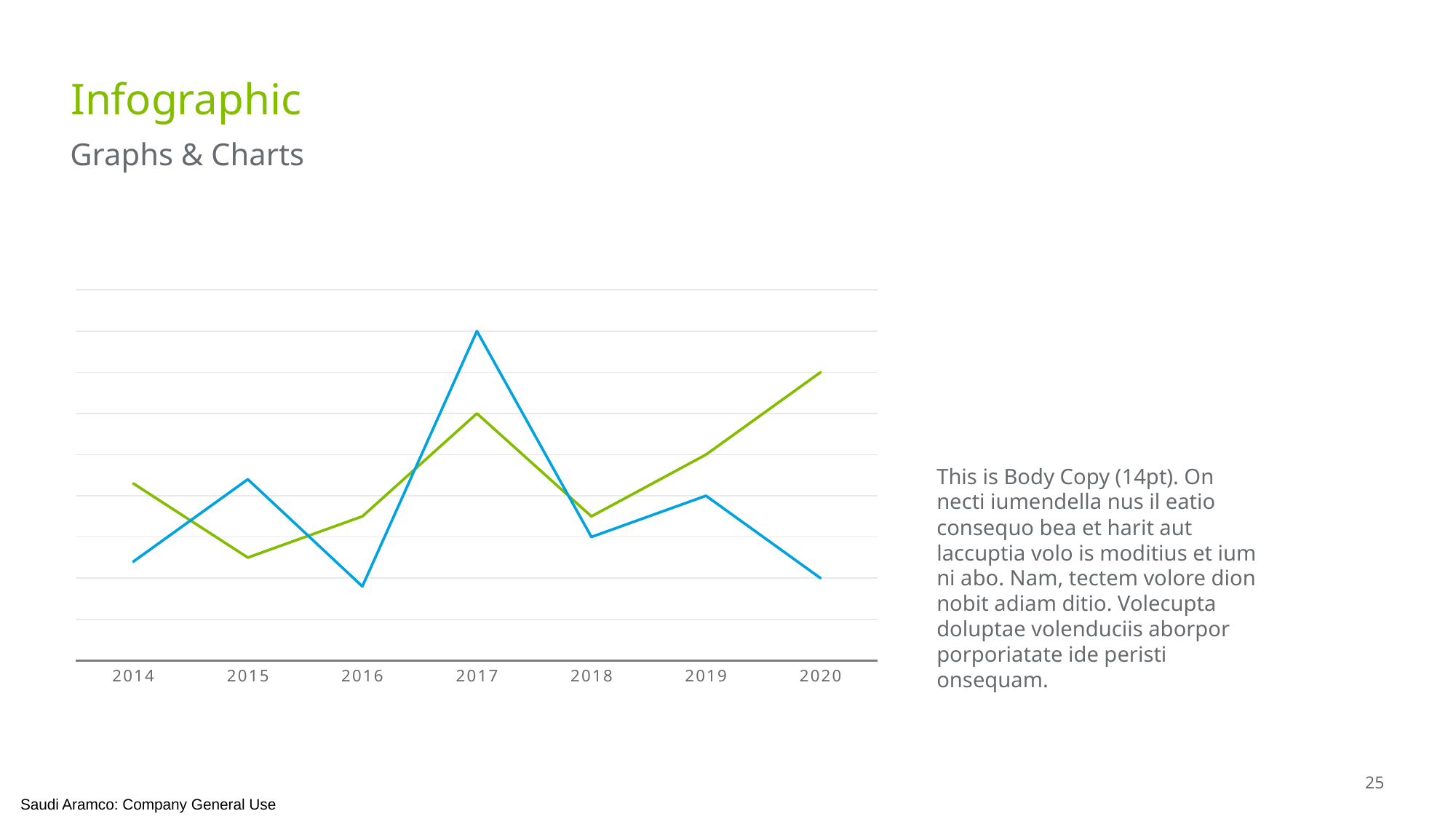
In which year does the blue line reach its lowest point? 2016 In which year does the green line reach its lowest point? 2015 In 2017, which line is higher, the blue line or the green line? Blue line What kind of chart is shown on the slide? Line chart Does the green line rise or fall from 2018 to 2020? Rise In which year does the blue line reach its highest point? 2017 How many lines are plotted on the chart? 2 In 2020, which line is higher, the blue line or the green line? Green line How many years are shown on the x axis of the chart? 7 In 2014, which line is higher, the blue line or the green line? Green line In which year does the green line reach its highest point? 2020 Does the blue line rise or fall from 2019 to 2020? Fall